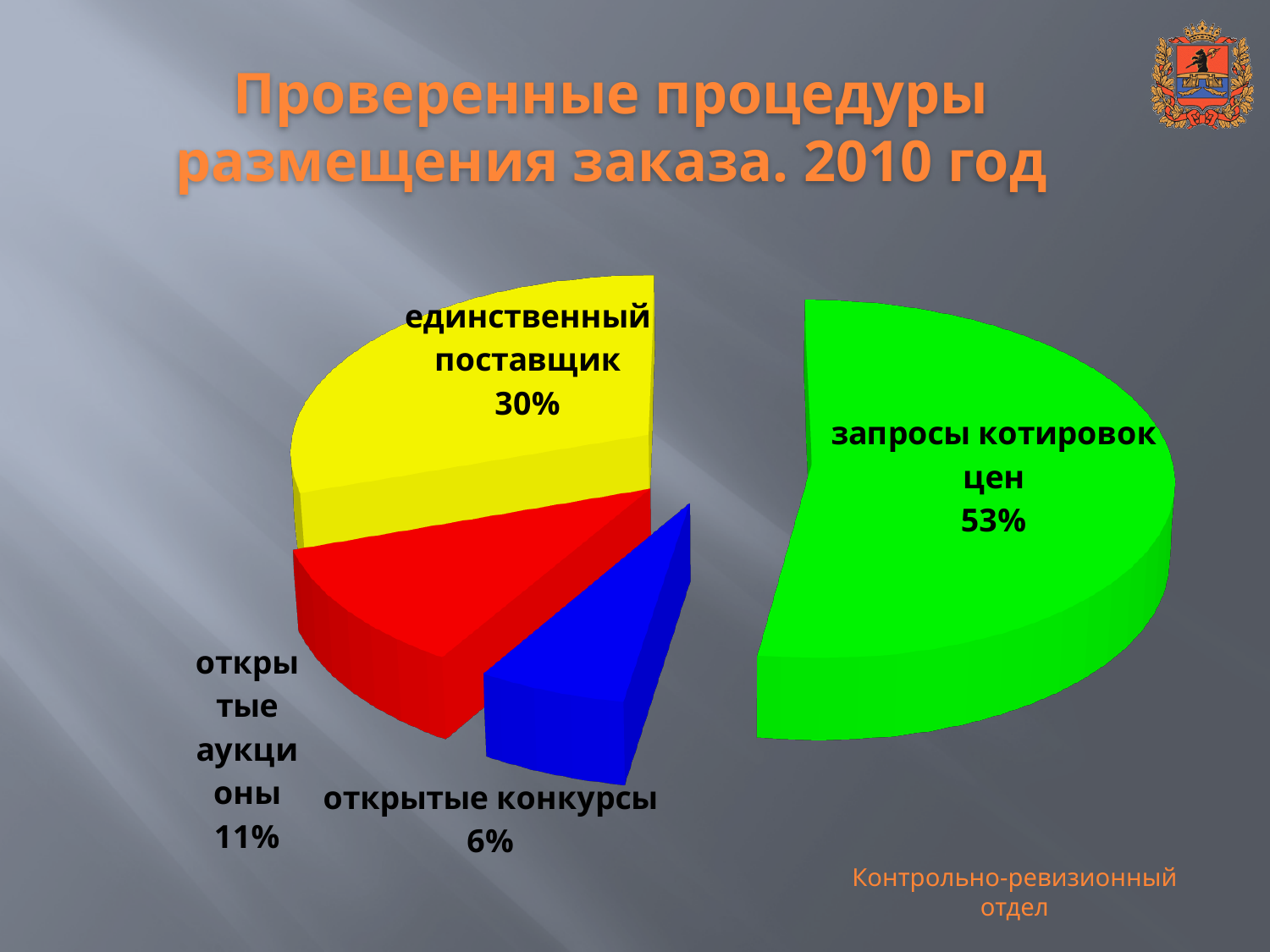
How many slices does the pie chart have? 4 What share of the pie is labelled 'запросы котировок цен'? 53% Which category has the largest slice of the pie? запросы котировок цен What kind of chart is shown on the slide? pie chart What share of the pie is labelled 'открытые аукционы'? 11% Which category has the smallest slice of the pie? открытые конкурсы What share of the pie is labelled 'открытые конкурсы'? 6% What colour is the slice for 'запросы котировок цен'? green What is the difference in percentage points between 'запросы котировок цен' and 'единственный поставщик'? 23 Which is larger, the share for 'открытые аукционы' or the share for 'открытые конкурсы'? открытые аукционы What is the title of the slide containing the chart? Проверенные процедуры размещения заказа. 2010 год